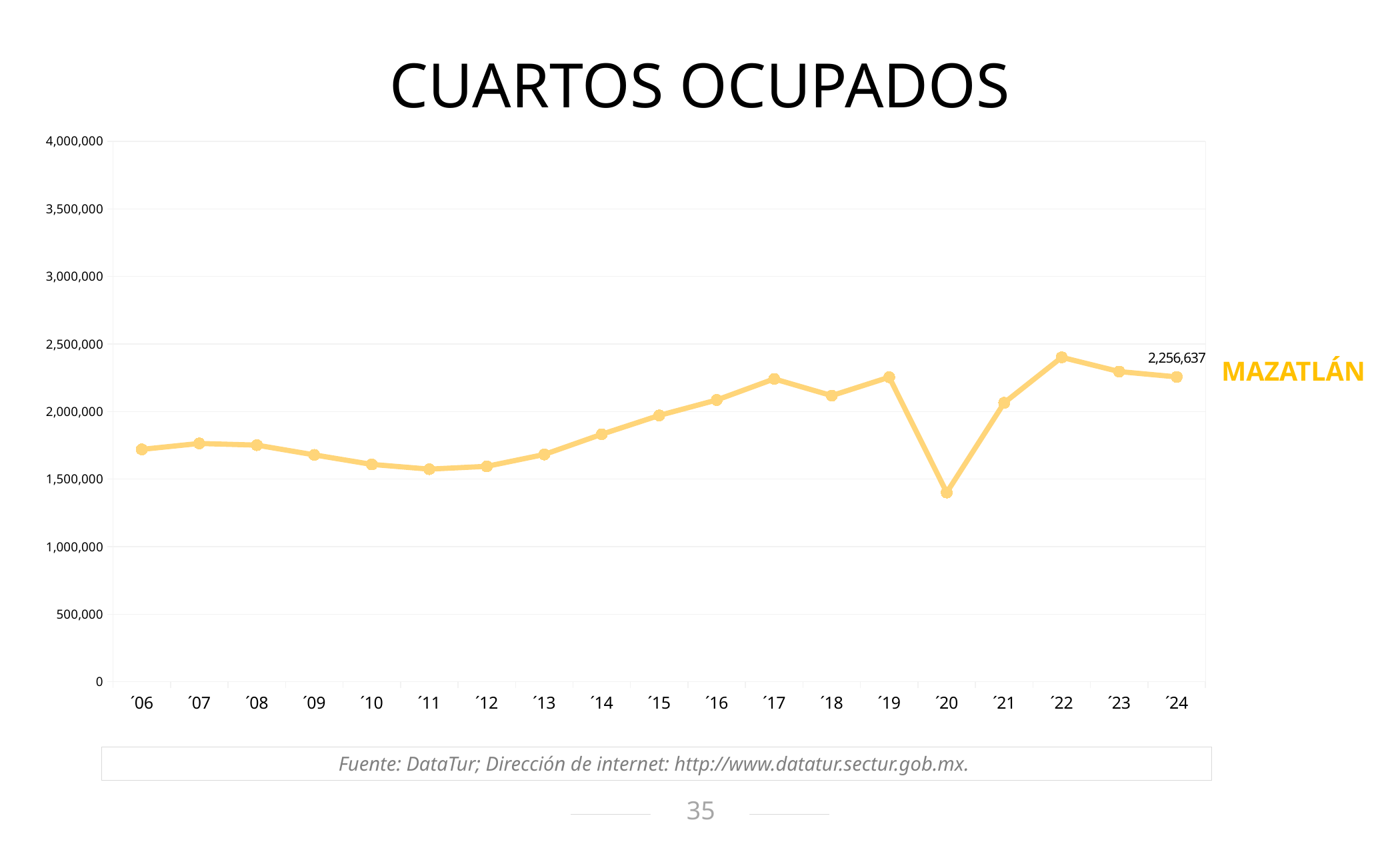
Which year has the lowest value on the chart? ´20 Is the value for ´20 greater or less than 1,500,000? less Is the value for ´22 greater or less than 2,000,000? greater What kind of chart is shown on the slide? line chart What is the title of the chart? CUARTOS OCUPADOS Which is larger, the value for ´21 or the value for ´20? ´21 Do the values rise or fall from ´12 to ´17? rise What is the value for ´24 on the Cuartos Ocupados chart? 2,256,637 Is the value for ´11 greater or less than 2,000,000? less Which is larger, the value for ´17 or the value for ´18? ´17 How many years are plotted on the chart? 19 Which year has the highest value on the chart? ´22